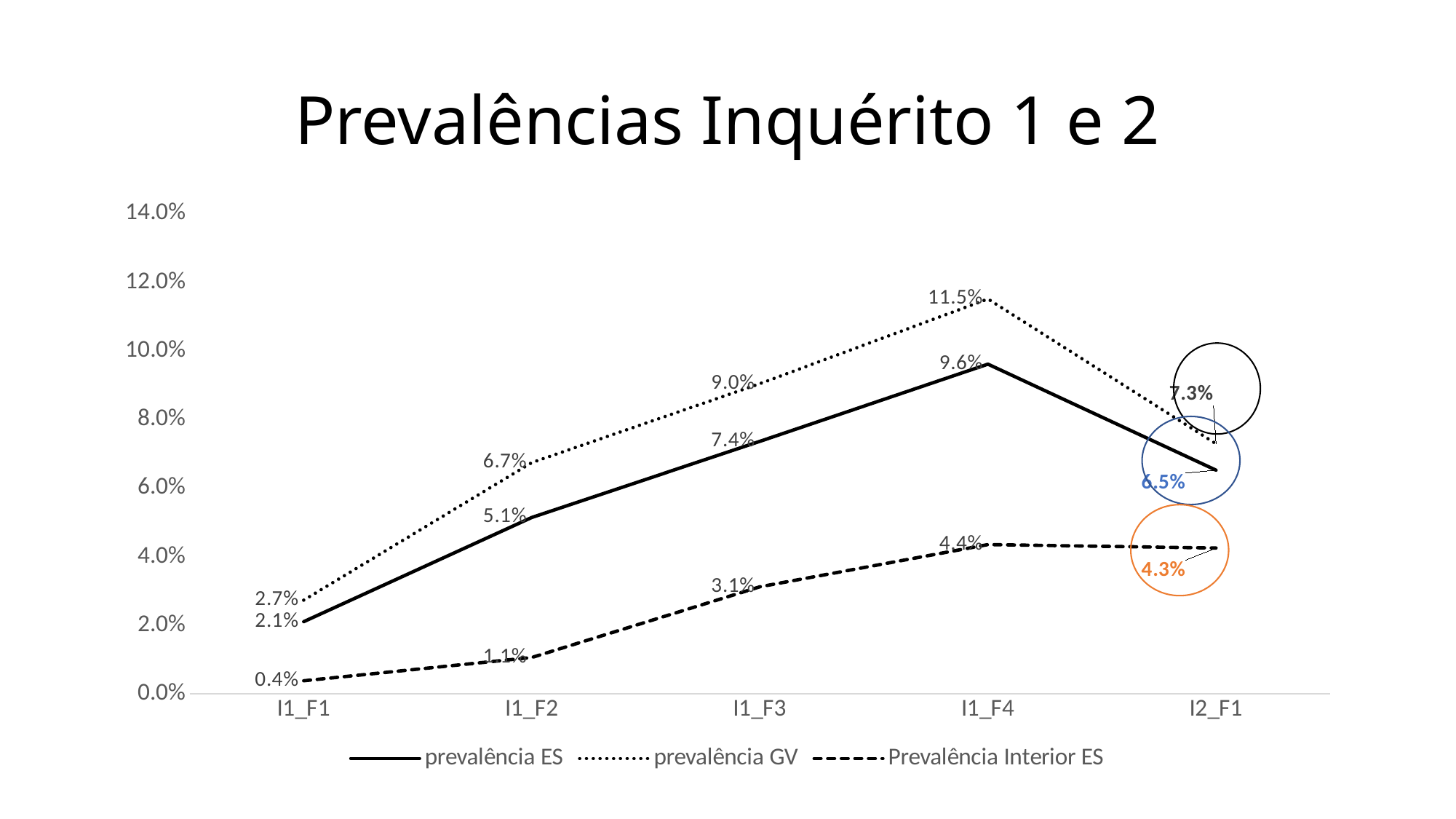
Is the value of prevalência GV at I1_F3 greater or less than 8.0%? greater At which category is Prevalência Interior ES lowest? I1_F1 What type of chart is shown on the slide? line chart What is the value of prevalência ES at I2_F1? 6.5% Which is larger at I1_F2: prevalência GV or prevalência ES? prevalência GV What is the value of prevalência ES at I1_F3? 7.4% How many series does the legend list? 3 What is the difference between prevalência GV and prevalência ES at I1_F4? 1.9% How many categories are shown on the x axis? 5 At which category does prevalência ES reach its highest value? I1_F4 What is the value of prevalência GV at I1_F4? 11.5% What is the value of Prevalência Interior ES at I1_F1? 0.4%